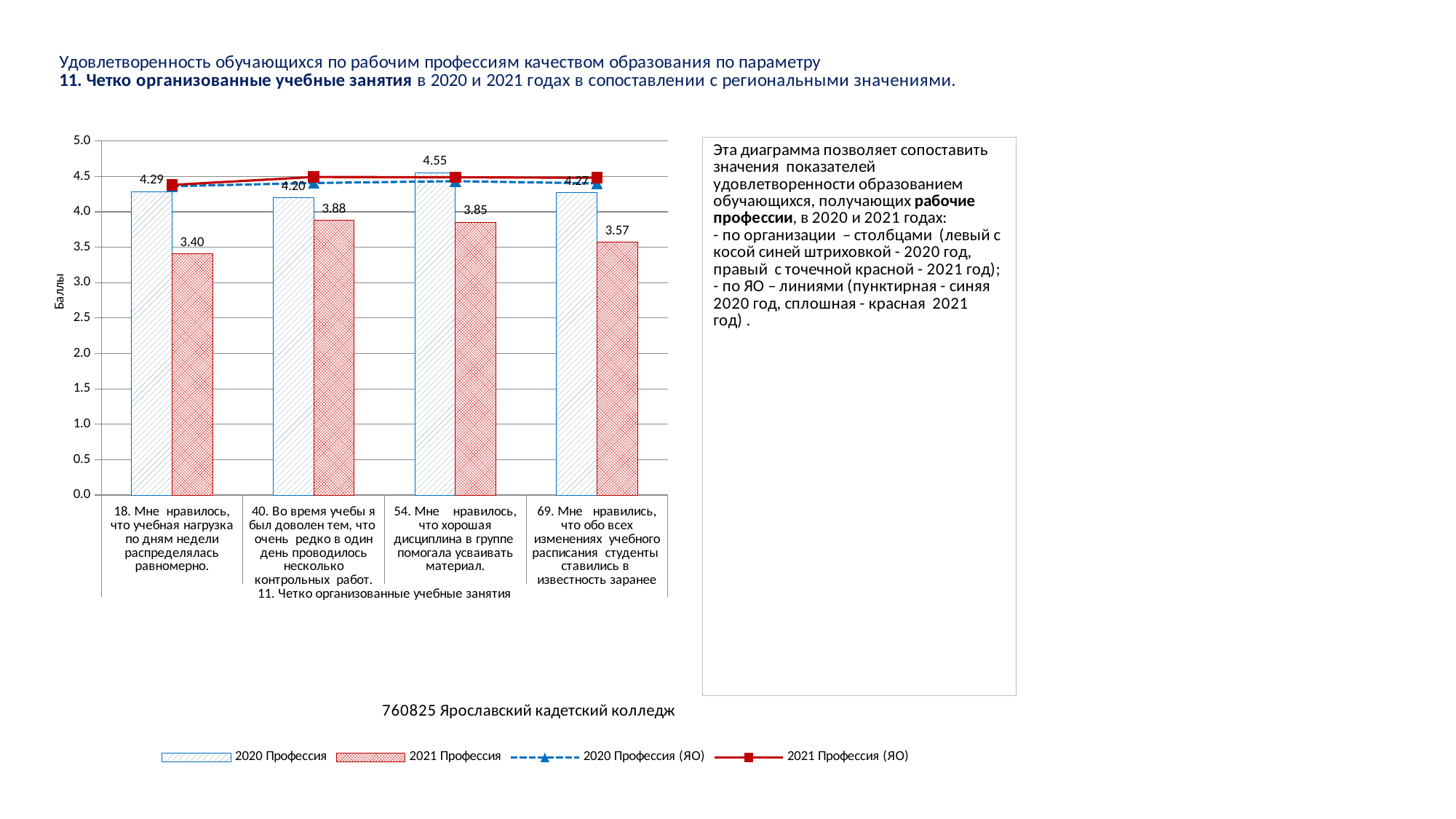
What is the difference between the 2020 and 2021 Профессия values for category 54? 0.70 How many series does the legend list? 4 What is the 2020 Профессия value for category 18 (Мне нравилось, что учебная нагрузка по дням недели распределялась равномерно)? 4.29 What kind of chart is shown on the slide? Combined bar and line chart For category 40, which is larger: the 2020 Профессия value or the 2021 Профессия value? 2020 Профессия What is the label of the y axis? Баллы What is the 2021 Профессия value for category 40 (Во время учебы я был доволен тем, что очень редко в один день проводилось несколько контрольных работ)? 3.88 How many categories are shown on the x axis? 4 Which category has the highest 2020 Профессия value? 54. Мне нравилось, что хорошая дисциплина в группе помогала усваивать материал. Which category has the lowest 2021 Профессия value? 18. Мне нравилось, что учебная нагрузка по дням недели распределялась равномерно. What is the 2021 Профессия value for category 69 (Мне нравились, что обо всех изменениях учебного расписания студенты ставились в известность заранее)? 3.57 Is the 2021 Профессия (ЯО) line value for category 18 greater or less than 4.0? greater